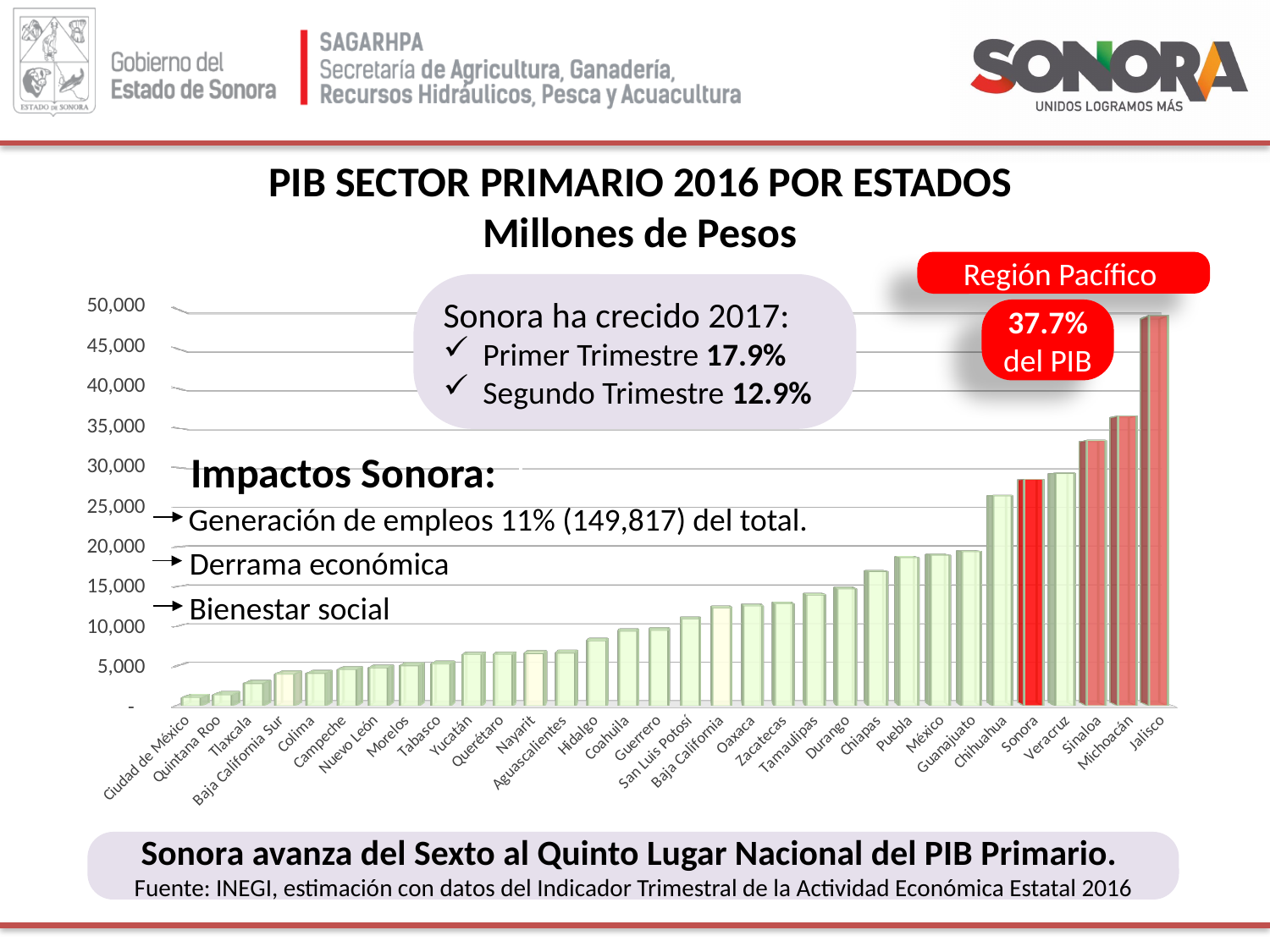
Which state has the lowest PIB sector primario 2016 in the chart? Ciudad de México Do the bar values rise or fall moving from left to right along the x axis? rise Which is larger, the value for Sonora or the value for Chihuahua? Sonora Is the value for Jalisco greater or less than 45,000? greater Which state has the highest PIB sector primario 2016 in the chart? Jalisco Which is larger, the value for Jalisco or the value for Michoacán? Jalisco Is the value for Sinaloa greater or less than 35,000? less What kind of chart is shown on the slide? bar chart Is the value for Sonora greater or less than 25,000? greater What is the title of the chart? PIB SECTOR PRIMARIO 2016 POR ESTADOS Millones de Pesos How many states (bars) are shown in the chart? 32